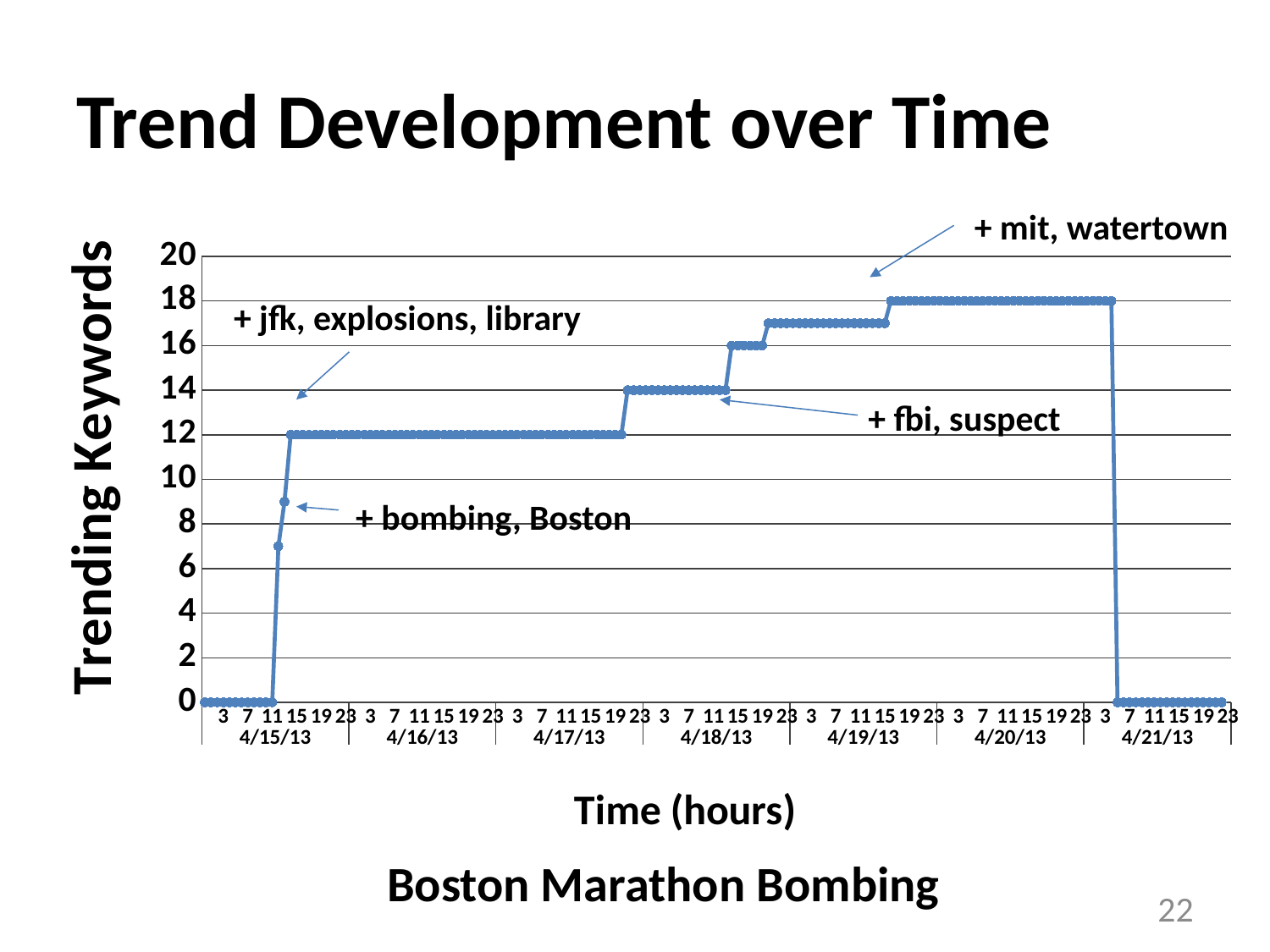
What is the highest number of trending keywords reached on the chart? 18 What kind of chart is shown on the slide? line chart What value does the line hold for most of 4/18/13? 14 What value does the line hold at the end of 4/21/13? 0 What value does the line hold throughout 4/16/13? 12 Which date has the higher value, 4/16/13 or 4/18/13? 4/18/13 Is the value for 4/19/13 greater or less than 16? greater How many dates are labelled along the x axis? 7 What is the title of the x axis of the chart? Time (hours) Which keywords are annotated at the step up to 18? + mit, watertown What value does the line hold throughout 4/20/13? 18 What is the difference between the value on 4/20/13 and the value on 4/16/13? 6